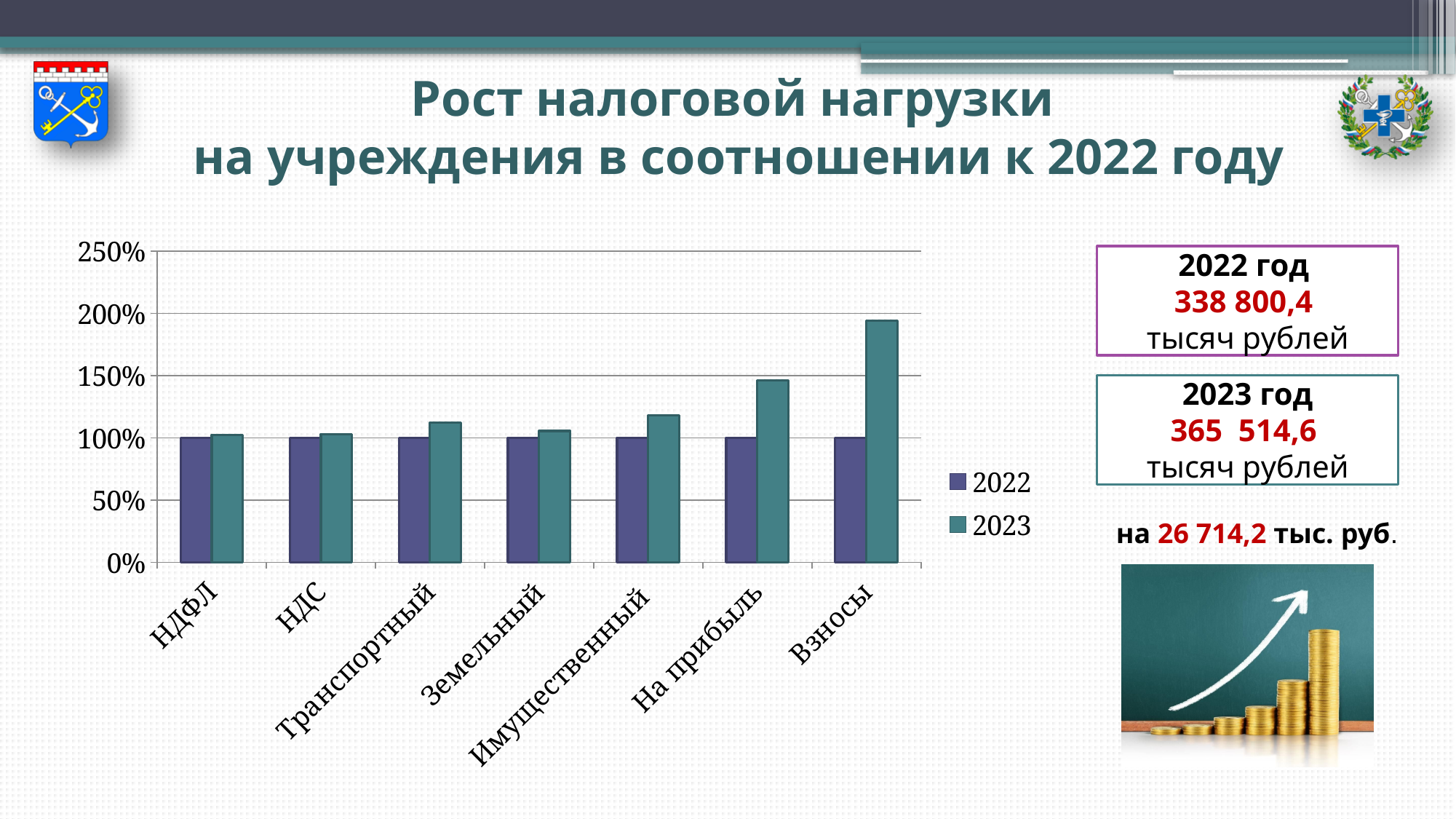
What is the value for НДФЛ in the 2022 series? 100% Which is larger in the 2023 series: the value for Транспортный or the value for Имущественный? Имущественный Which series are listed in the chart legend? 2022 and 2023 Is the 2023 value for Имущественный greater or less than 100%? greater What is the value for Взносы in the 2022 series? 100% How many series does the chart legend list? 2 Is the 2023 value for Взносы greater or less than 150%? greater Which is larger in the 2023 series: the value for Взносы or the value for На прибыль? Взносы Which category has the highest value in the 2023 series? Взносы How many categories are shown on the x axis of the chart? 7 What kind of chart is shown on the slide? bar chart